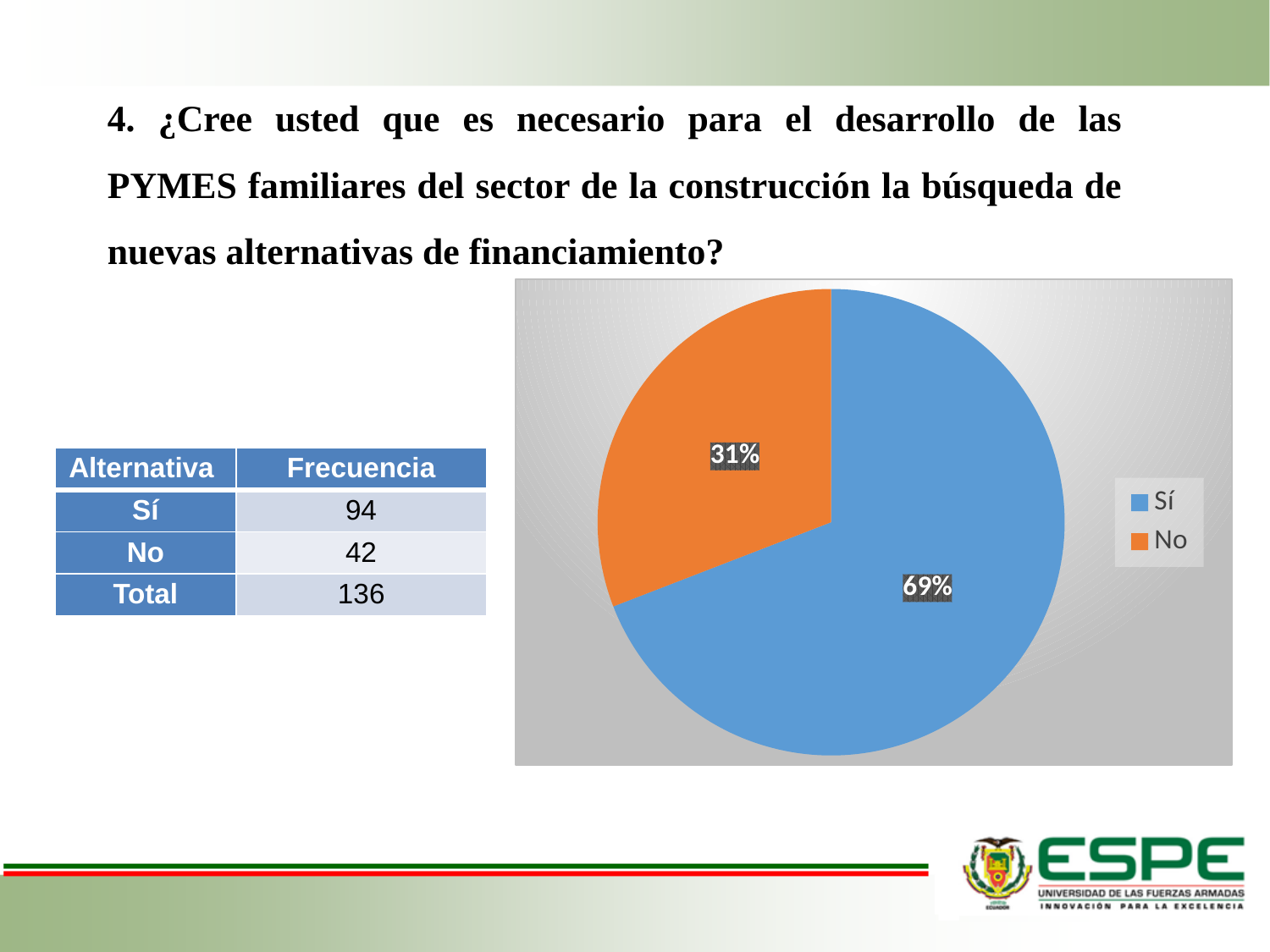
Which slice is larger, "Sí" or "No"? Sí What is the share of the pie taken by the "No" slice? 31% What colour is the "No" slice in the pie chart? orange What is the difference in percentage points between the "Sí" and "No" slices? 38 Which category has the smallest slice of the pie? No What kind of chart is shown on the slide? pie chart What percentage of the pie does the "Sí" slice represent? 69% What colour is the "Sí" slice in the pie chart? blue Which category has the largest slice of the pie? Sí How many slices does the pie chart have? 2 How many entries does the legend list? 2 What percentage of the pie does the "No" slice represent? 31%